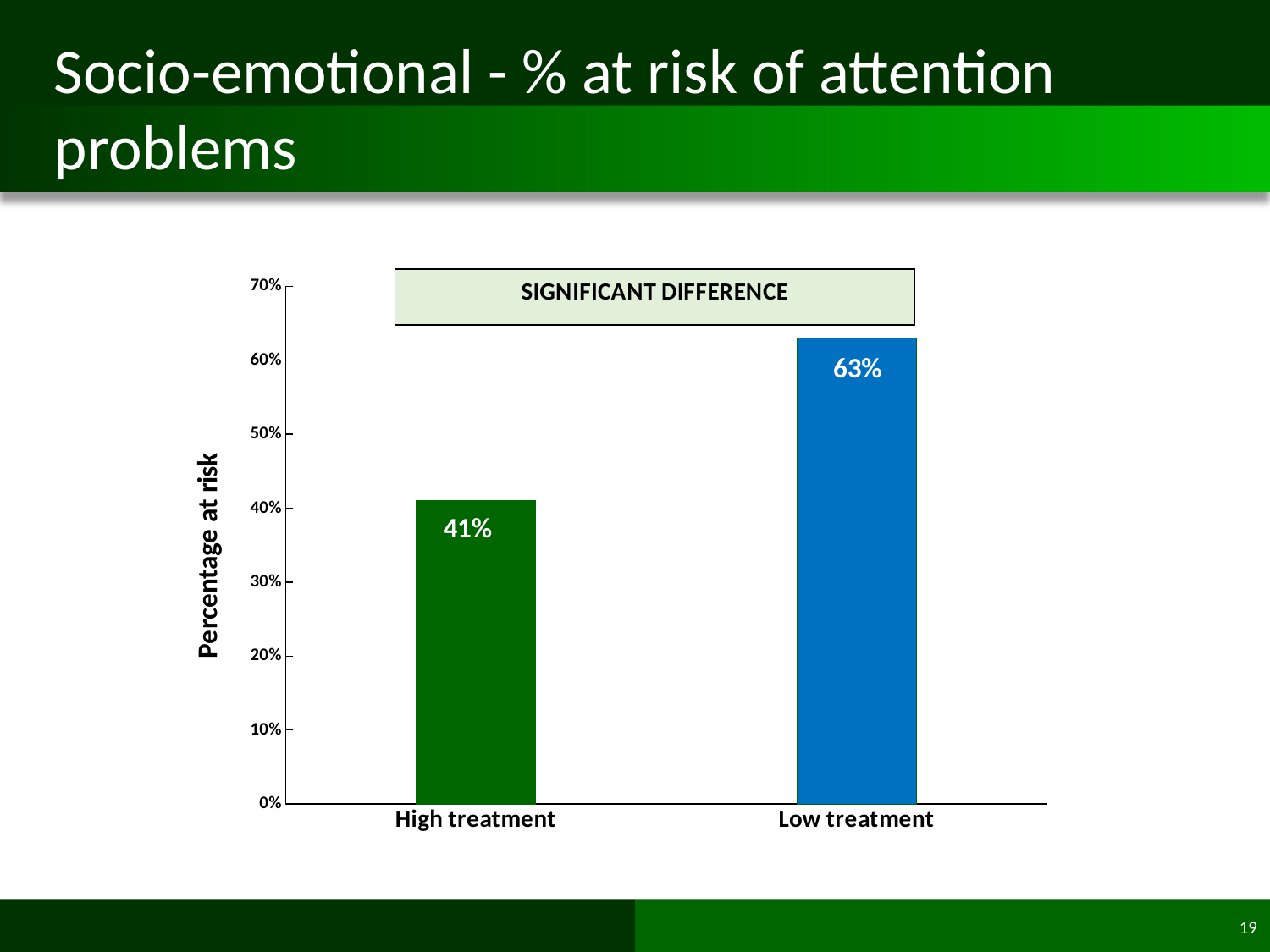
What is the label of the y axis? Percentage at risk Is the value for High treatment greater or less than the value for Low treatment? less What kind of chart is shown on the slide? Bar chart What is the difference in percentage at risk between the Low treatment and High treatment groups? 22% Is the value for High treatment greater or less than 40%? greater Is the value for Low treatment greater or less than 50%? greater How many categories are shown on the x axis? 2 What text appears in the box above the bars? SIGNIFICANT DIFFERENCE Which group has the lower percentage at risk of attention problems? High treatment What is the percentage at risk for the Low treatment group? 63% Which group has the higher percentage at risk of attention problems? Low treatment What is the percentage at risk for the High treatment group? 41%